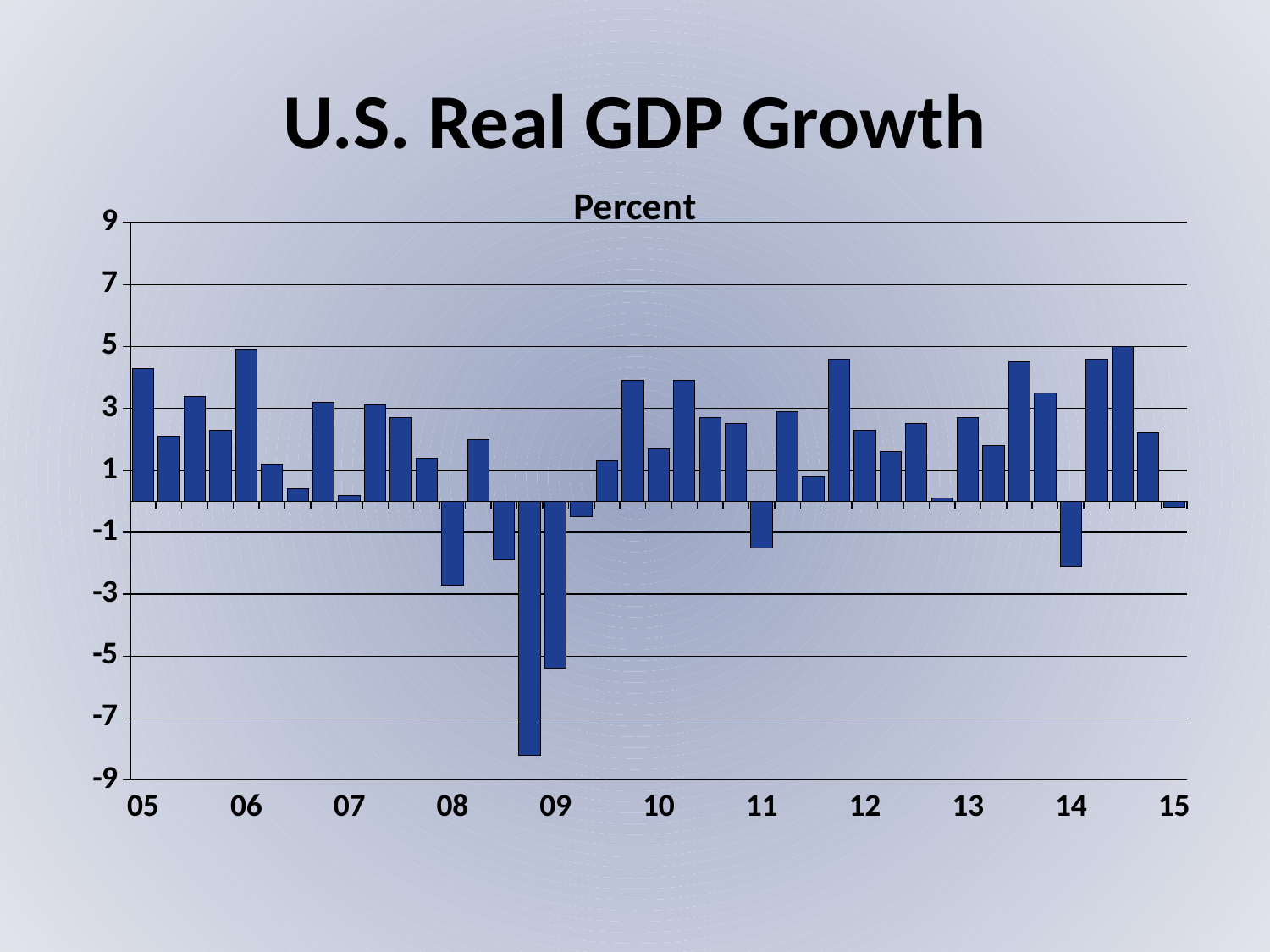
Is the bar at the 05 label larger or smaller than the bar at the 15 label? larger What unit label is shown above the chart's vertical axis? Percent Is the value of the bar at the 08 label greater or less than -1? less Is the value of the first bar at the 05 label greater or less than 3? greater Is the value of the bar at the 15 label greater or less than 1? less How many year labels are shown along the x axis? 11 What kind of chart is shown on the slide? bar chart What is the title of the chart? U.S. Real GDP Growth What is the highest value shown on the vertical axis? 9